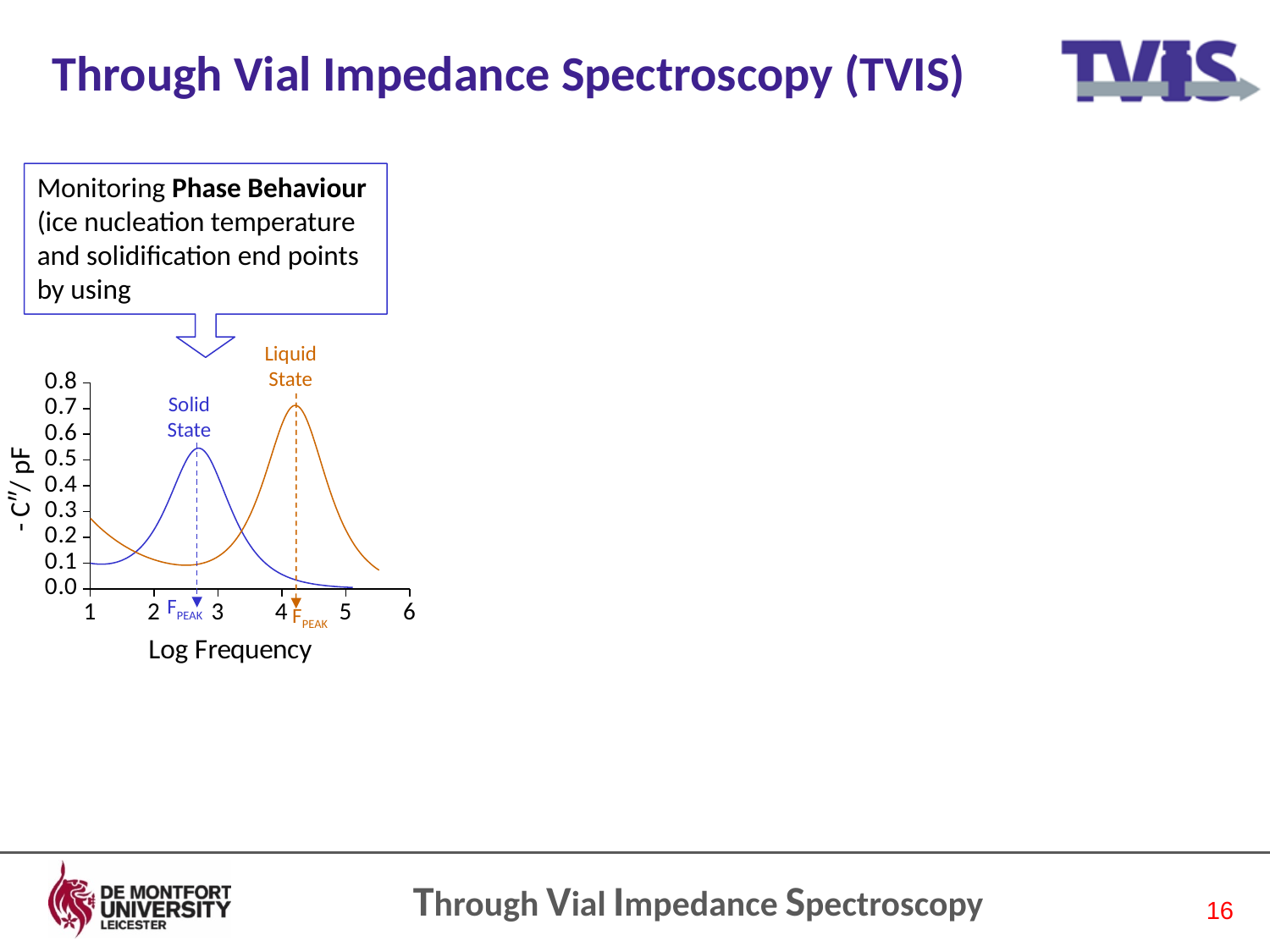
Is the Log Frequency at the Liquid State peak (F PEAK) greater or less than 4? greater Is the Log Frequency at the Solid State peak (F PEAK) greater or less than 3? less Which curve reaches the higher peak value of -C''/pF, Solid State or Liquid State? Liquid State What is the label of the y axis of the chart? - C''/ pF Is the peak value of the Solid State curve greater or less than 0.4? greater What kind of chart is shown on the slide? line chart What is the label of the x axis of the chart? Log Frequency Which curve has its peak at the higher Log Frequency, Solid State or Liquid State? Liquid State How many curves (states) are plotted on the chart? 2 What colour is the Solid State curve on the chart? blue